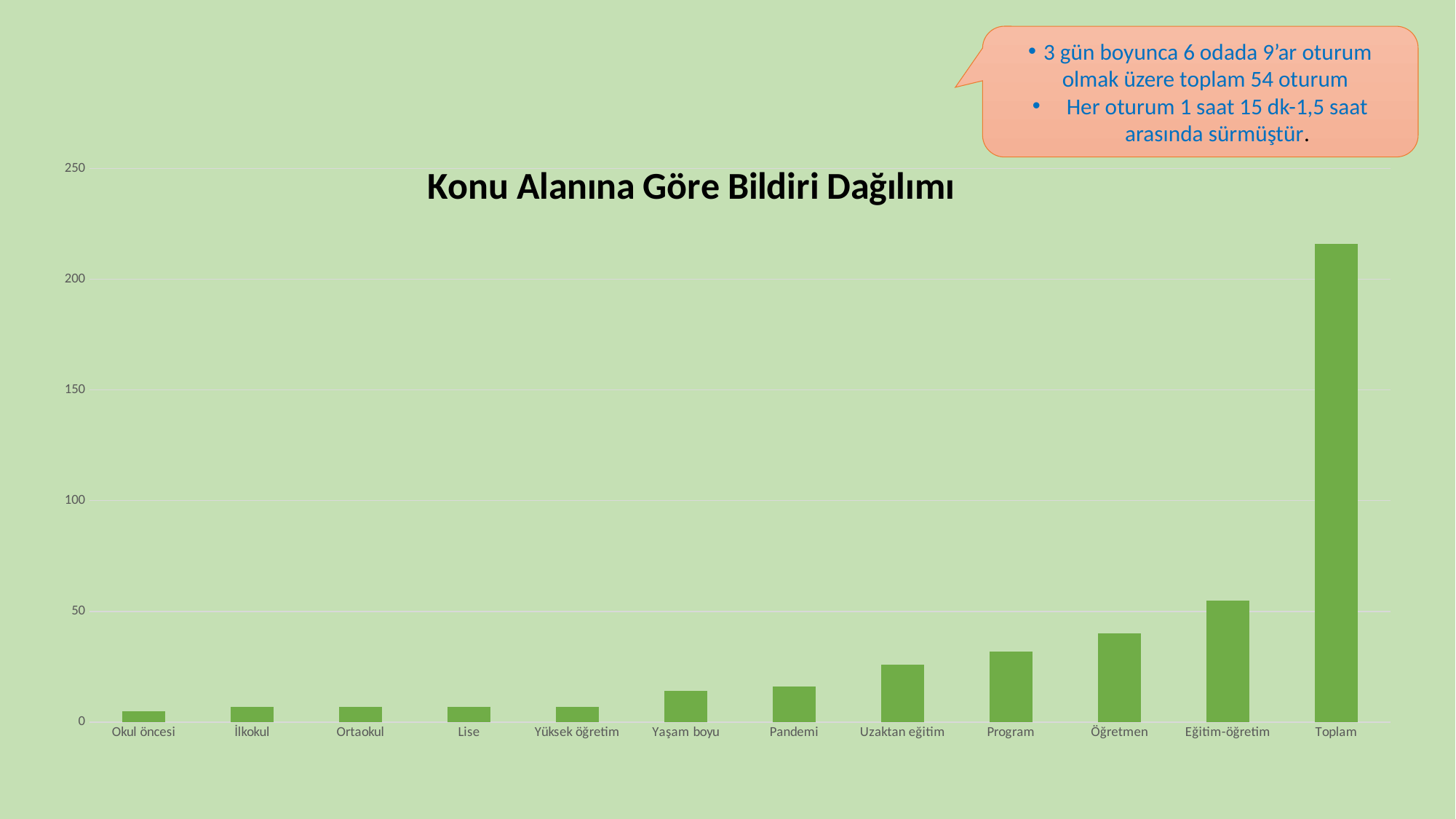
Is the value for Eğitim-öğretim greater or less than 50? greater Which is larger, the value for Eğitim-öğretim or the value for Öğretmen? Eğitim-öğretim How many categories are shown on the x axis of the chart? 12 Do the bar values generally rise or fall from left to right along the x axis? rise What is the title of the chart? Konu Alanına Göre Bildiri Dağılımı Is the value for Toplam greater or less than 200? greater Which category has the lowest bar in the chart? Okul öncesi Which category has the highest bar in the chart? Toplam Which is larger, the value for Öğretmen or the value for Program? Öğretmen Is the value for Öğretmen greater or less than 50? less What kind of chart is shown on the slide? bar chart